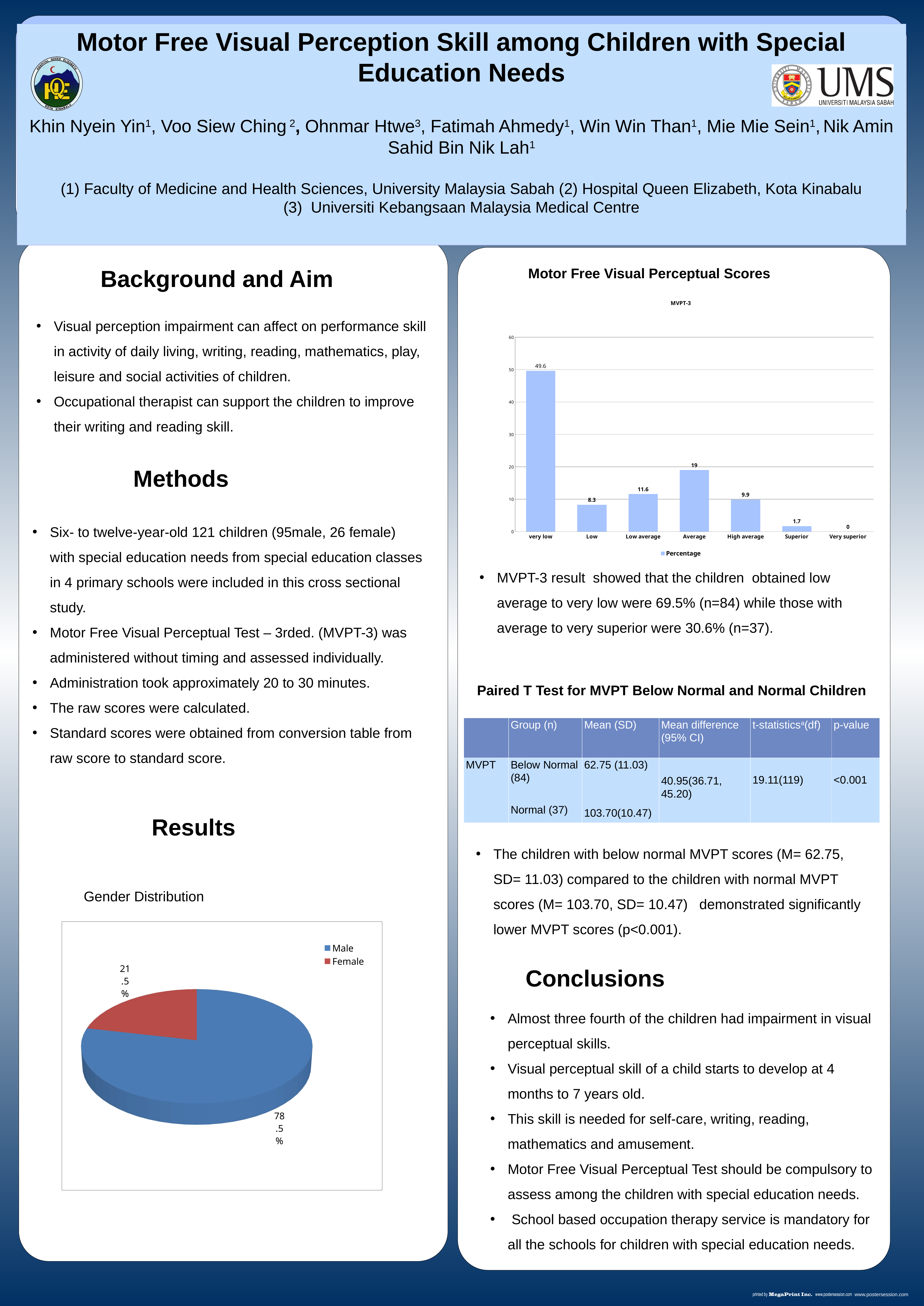
In the MVPT-3 bar chart, what is the percentage for the 'Superior' category? 1.7 In the MVPT-3 bar chart, what is the percentage for the 'very low' category? 49.6 What is the single legend entry of the MVPT-3 bar chart? Percentage How many categories are shown on the x axis of the MVPT-3 bar chart? 7 In the MVPT-3 bar chart, what is the percentage for the 'Average' category? 19 In the MVPT-3 bar chart, which category has the lowest percentage? Very superior In the MVPT-3 bar chart, what is the difference between the 'Low average' and 'Low' percentages? 3.3 In the MVPT-3 bar chart, which category has the highest percentage? very low In the MVPT-3 bar chart, which is larger, the percentage for 'High average' or for 'Low'? High average What kind of chart is the MVPT-3 chart? Bar chart How many series does the legend of the Gender Distribution pie chart list? 2 In the Gender Distribution pie chart, what share is Male? 78.5%